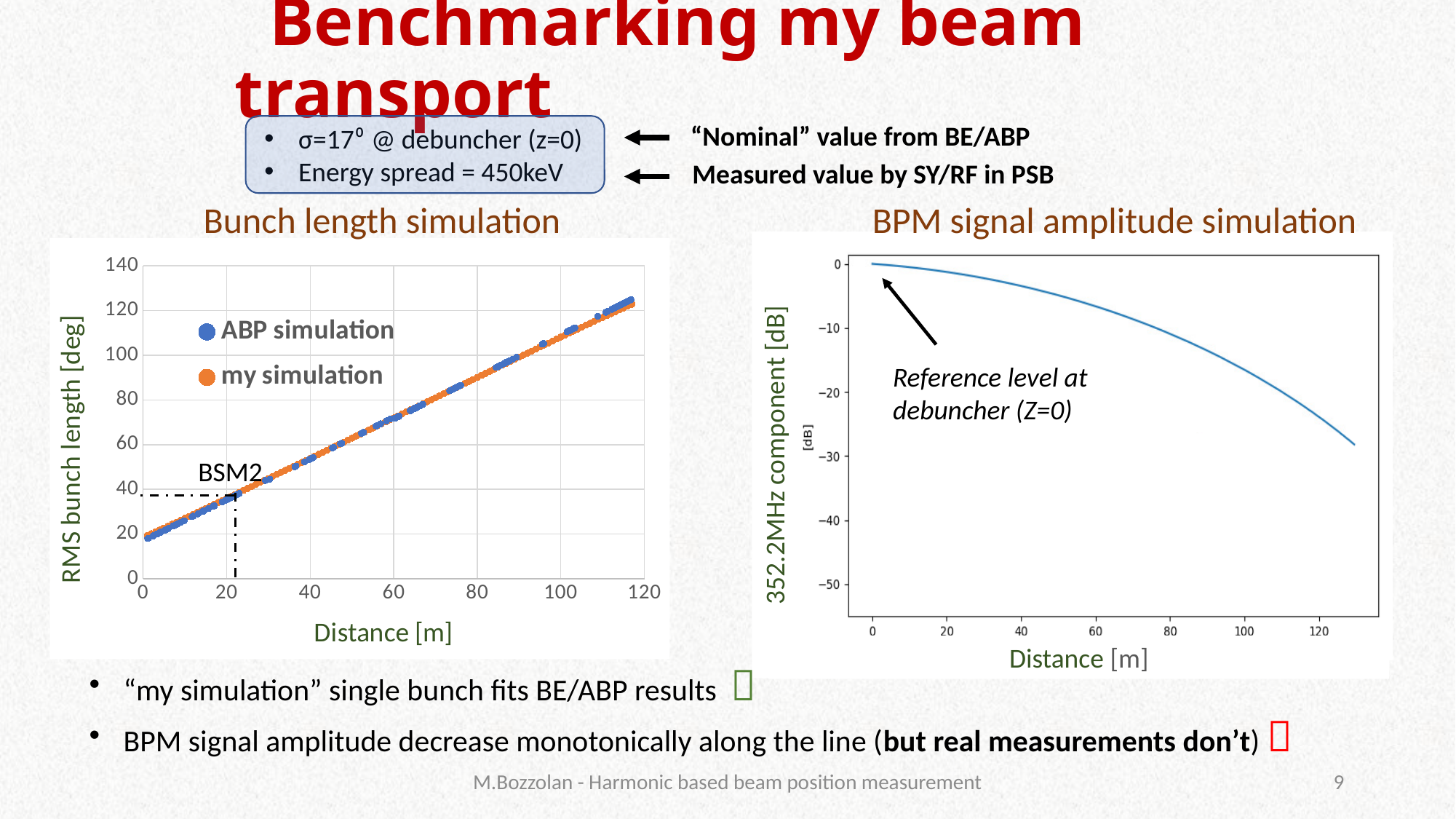
In the 'BPM signal amplitude simulation' chart, is the value at a distance of 40 m greater or less than -10 dB? greater In the 'Bunch length simulation' chart, what is the label of the y axis? RMS bunch length [deg] In the 'Bunch length simulation' chart, is the RMS bunch length at a distance of 60 m greater or less than 60 deg? greater In the 'BPM signal amplitude simulation' chart, at which distance is the signal amplitude highest? 0 m In the 'Bunch length simulation' chart, what are the two series named in the legend? ABP simulation and my simulation In the 'Bunch length simulation' chart, is the RMS bunch length at a distance of 120 m greater or less than 120 deg? greater In the 'Bunch length simulation' chart, how many series does the legend list? 2 In the 'Bunch length simulation' chart, do the values rise or fall as distance increases? rise In the 'BPM signal amplitude simulation' chart, what kind of chart is shown? line chart In the 'BPM signal amplitude simulation' chart, do the values rise or fall as distance increases? fall